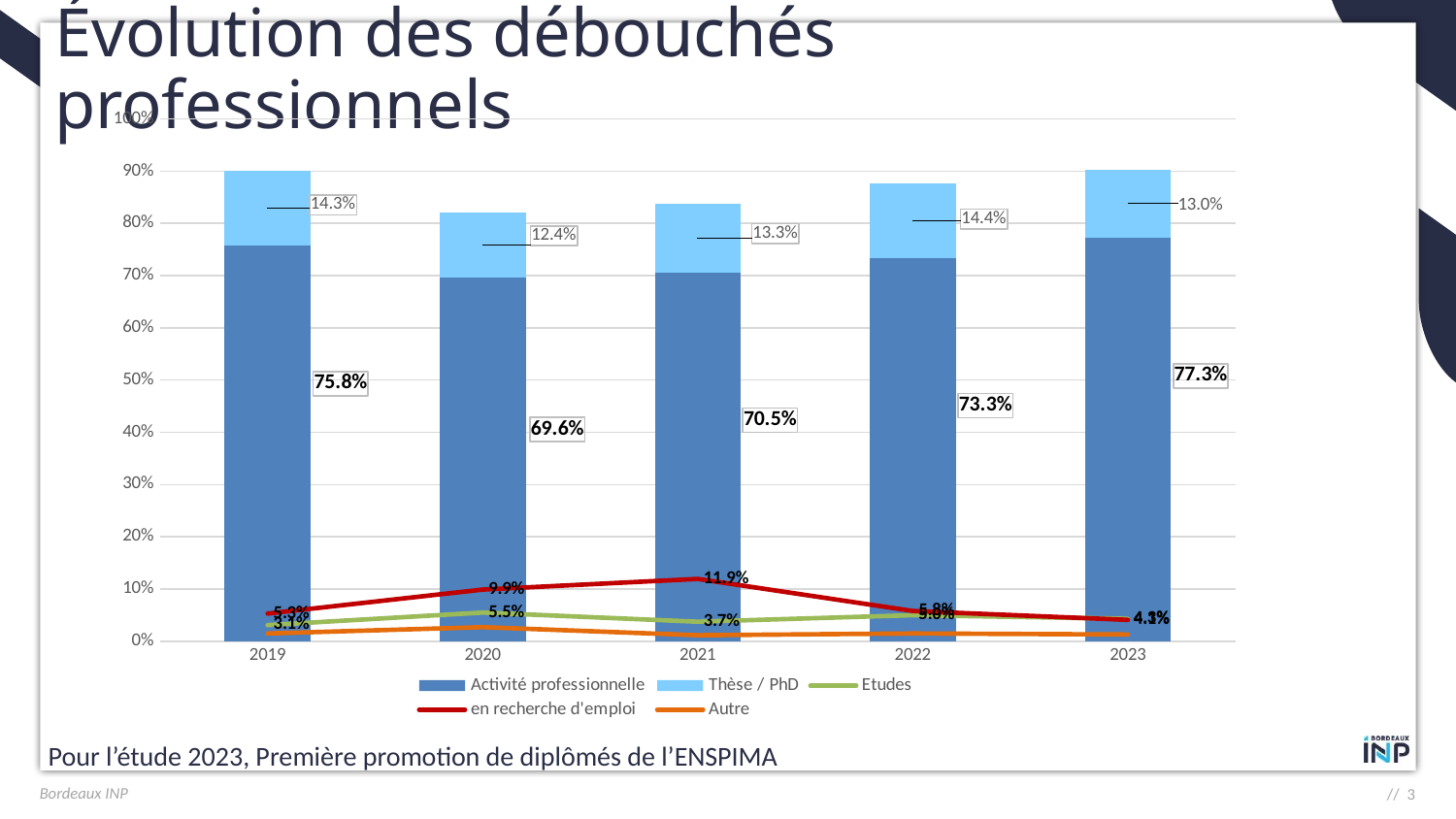
What is the value for Thèse / PhD in 2022? 14.4% What is the combined total of the stacked bar (Activité professionnelle plus Thèse / PhD) for 2023? 90.3% What is the value for 'en recherche d'emploi' in 2021? 11.9% How many series does the legend list? 5 In which year is the Activité professionnelle share the lowest? 2020 What is the value for Etudes in 2020? 5.5% What is the title of the slide containing the chart? Évolution des débouchés professionnels In which year is the Activité professionnelle share the highest? 2023 What is the difference between the Activité professionnelle values for 2023 and 2020? 7.7 percentage points Which year has the larger Thèse / PhD value, 2019 or 2020? 2019 How many years are shown on the x axis? 5 What is the value for Activité professionnelle in 2019? 75.8%